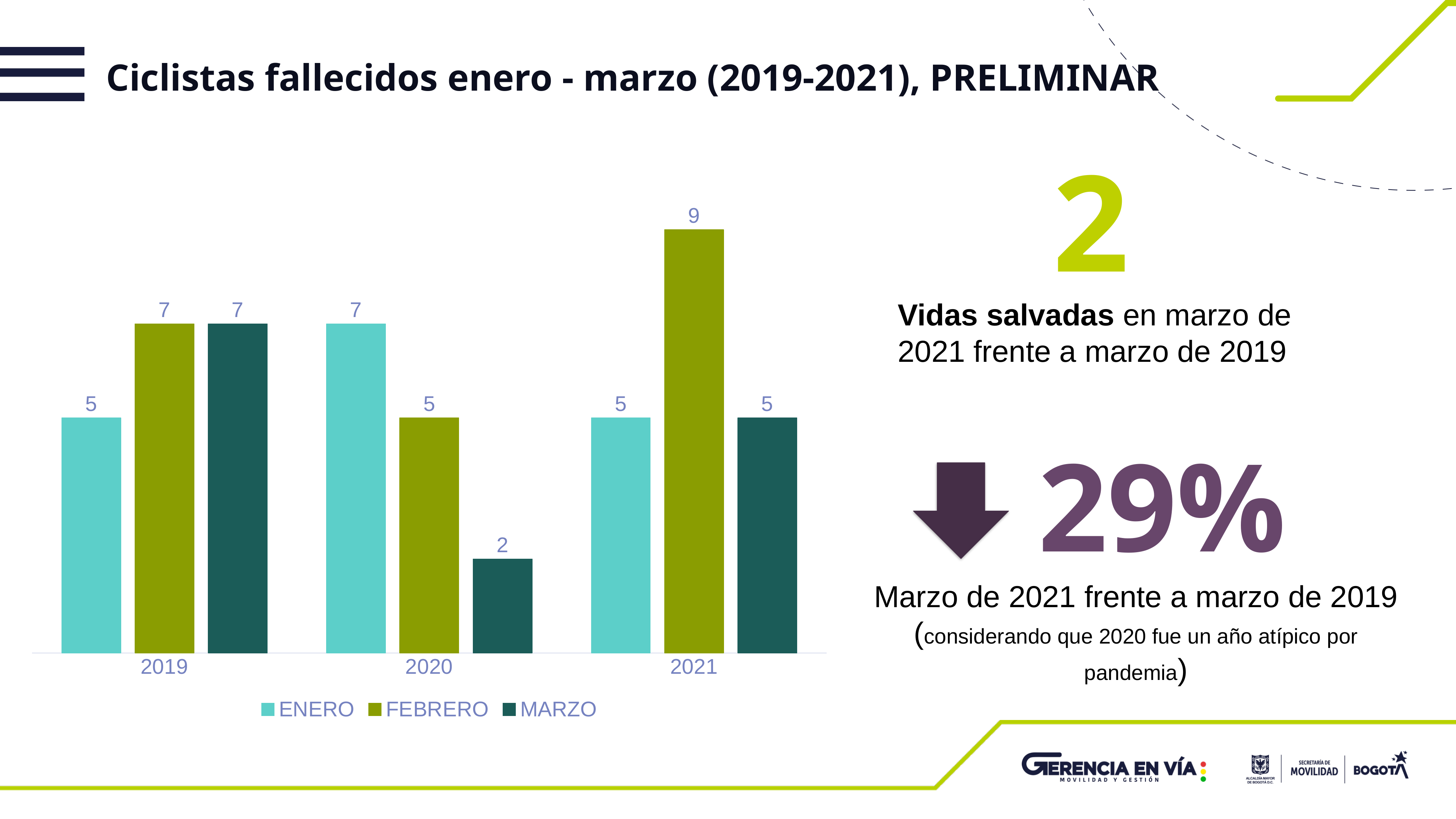
What is the value for ENERO in 2019? 5 What kind of chart is shown on the slide? Bar chart How many years are shown on the x axis? 3 What is the value for MARZO in 2019? 7 What is the value for MARZO in 2020? 2 What is the difference between the MARZO values for 2019 and 2021? 2 How many series does the legend list? 3 Which year has the lowest MARZO value? 2020 What is the value for FEBRERO in 2021? 9 Which is larger, ENERO in 2020 or ENERO in 2021? ENERO in 2020 Which series is shown in the darkest green colour? MARZO Which year has the highest FEBRERO value? 2021